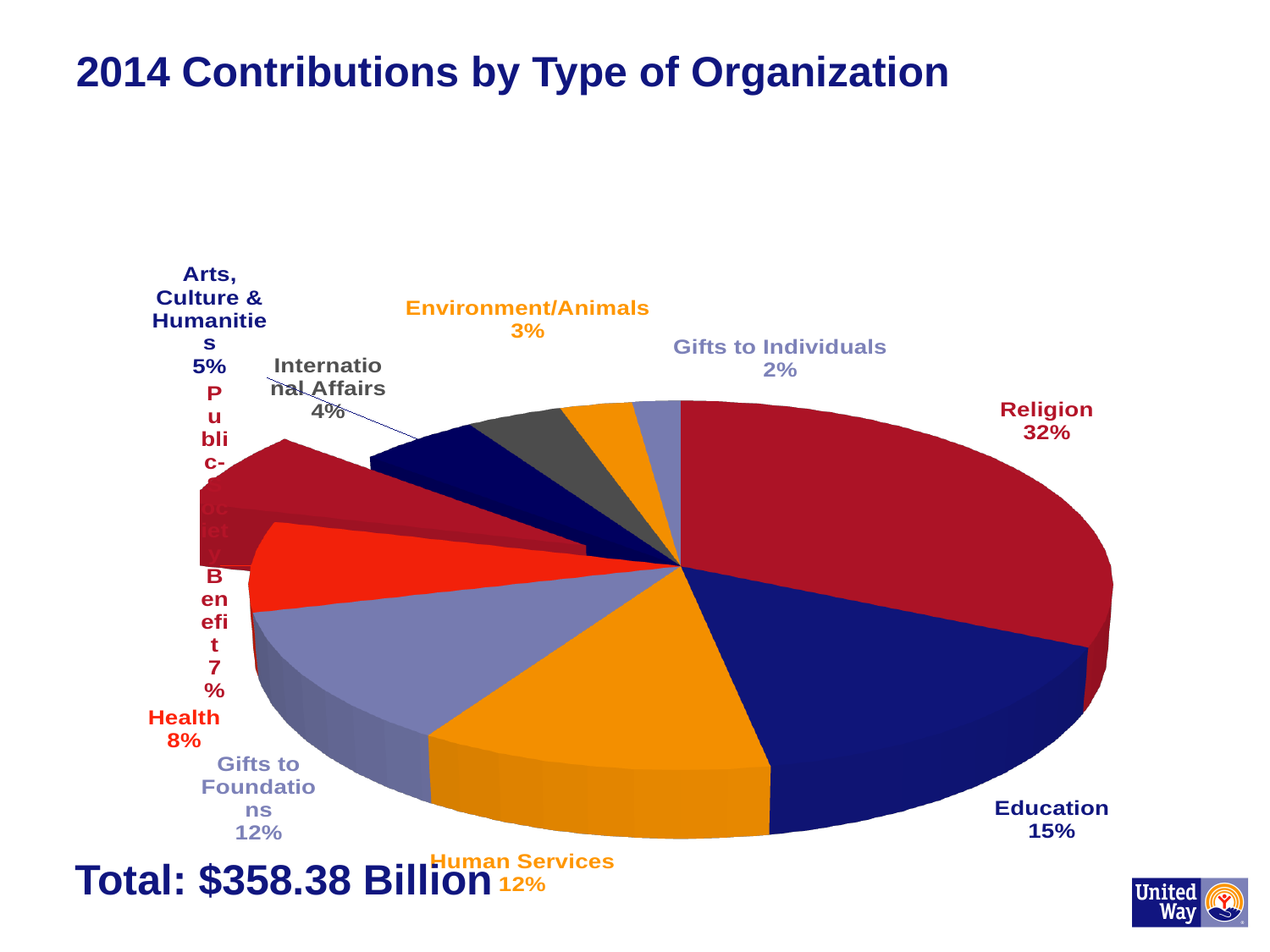
What percentage of 2014 contributions went to Religion? 32% What kind of chart is shown on the slide? Pie chart What percentage is shown for Health? 8% Which type of organization received the largest share of contributions? Religion What share of contributions went to Education? 15% How many percentage points larger is the Religion share than the Education share? 17 percentage points How many categories are shown in the pie chart? 10 What total dollar amount of contributions is stated on the slide? $358.38 Billion What share of contributions went to International Affairs? 4% What percentage is shown for Environment/Animals? 3% Which received a larger share of contributions, Human Services or Health? Human Services Which category has the smallest share of the pie? Gifts to Individuals